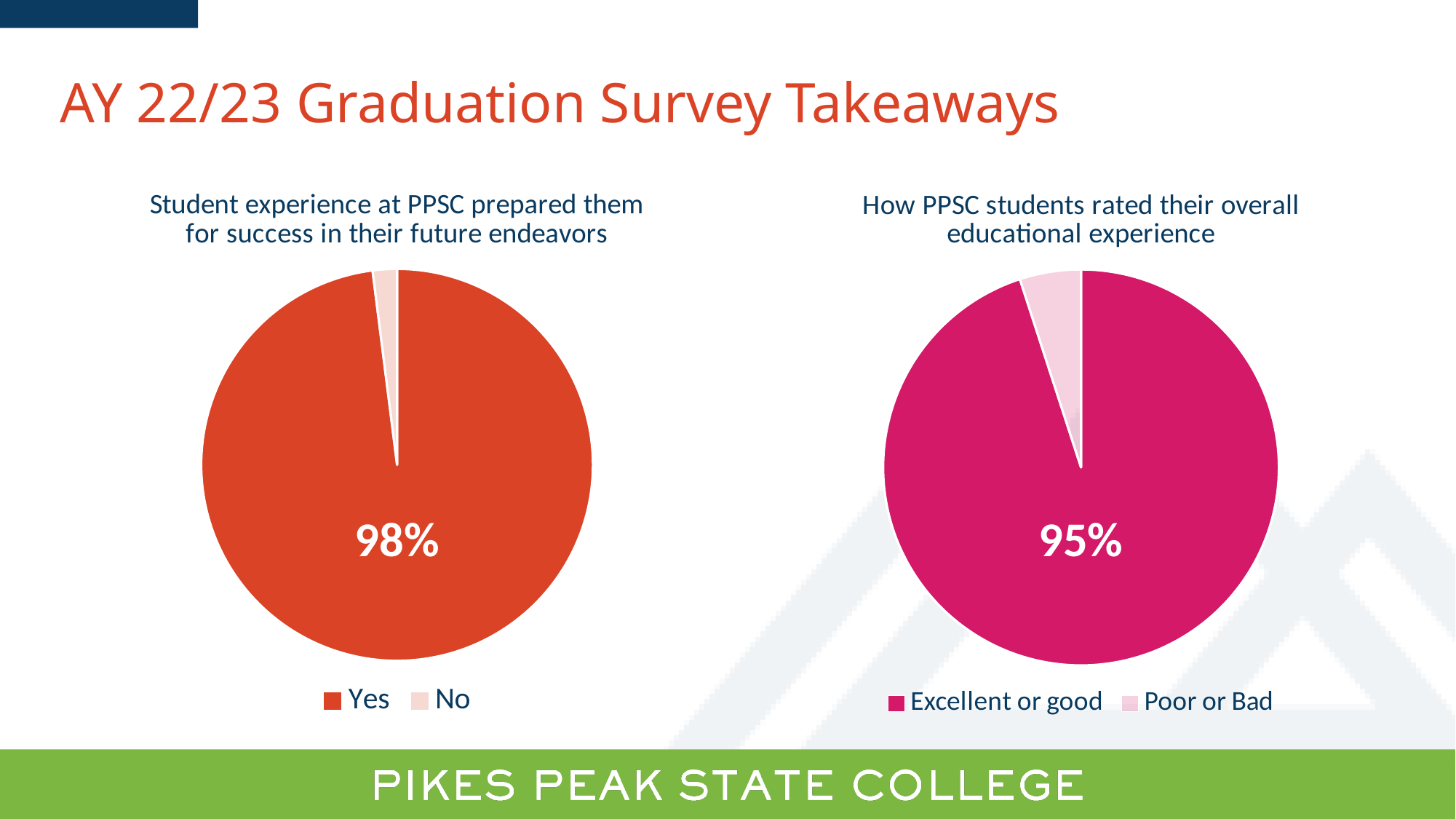
What are the two legend entries of the left pie chart? Yes and No Which is larger: the Yes share in the left pie chart or the Excellent or good share in the right pie chart? Yes share in the left pie chart What kind of chart is used on the right side of the slide? Pie chart In the right pie chart, which category has the smallest slice? Poor or Bad How many entries does the legend of the right pie chart list? 2 In the right pie chart, what share of students rated their overall educational experience as Excellent or good? 95% What is the difference between the Yes share in the left pie chart (98%) and the Excellent or good share in the right pie chart (95%)? 3 percentage points How many slices does the left pie chart have? 2 What kind of chart is used on the left side of the slide? Pie chart In the left pie chart, what share of students said their experience at PPSC prepared them for success in their future endeavors? 98% In the left pie chart, which category has the largest slice? Yes What is the title of the right pie chart? How PPSC students rated their overall educational experience